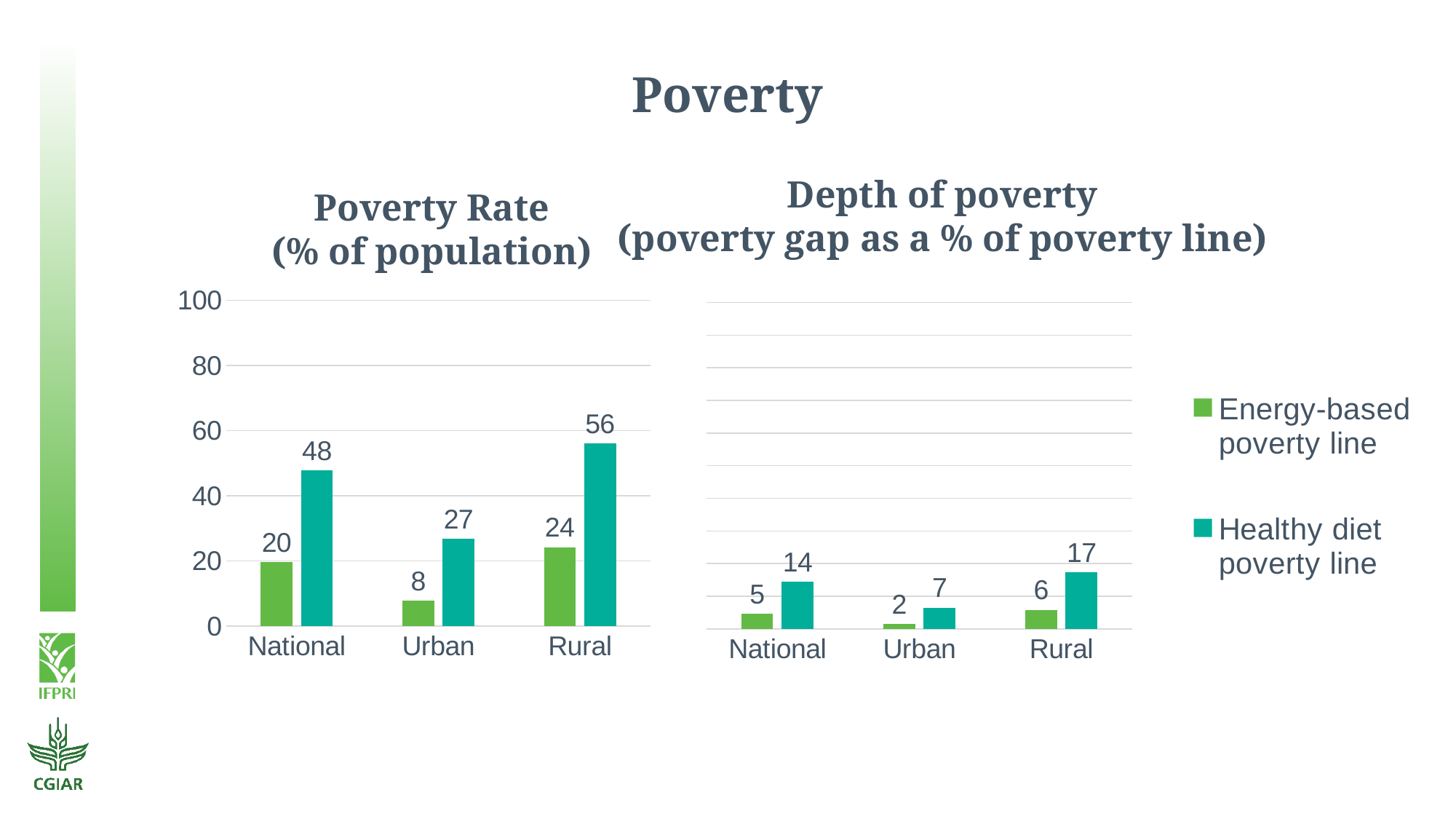
In the Depth of poverty chart, what is the value for National under the Healthy diet poverty line? 14 In the Poverty Rate chart, which is larger: the Energy-based poverty line value for Rural or the Healthy diet poverty line value for Urban? Healthy diet poverty line value for Urban In the Depth of poverty chart, what is the value for Urban under the Energy-based poverty line? 2 In the Depth of poverty chart, which category has the lowest Energy-based poverty line value? Urban In the Poverty Rate chart, what is the value for Urban under the Energy-based poverty line? 8 In the Poverty Rate chart, which category has the highest Healthy diet poverty line value? Rural In the Depth of poverty chart, what is the difference between the Healthy diet and Energy-based poverty line values for Rural? 11 How many categories are shown on the x axis of the Poverty Rate chart? 3 In the Poverty Rate chart, what is the difference between the Healthy diet and Energy-based poverty line values for National? 28 What kind of chart is the Depth of poverty chart? Bar chart How many series does the legend list? 2 In the Poverty Rate chart, what is the value for Rural under the Healthy diet poverty line? 56